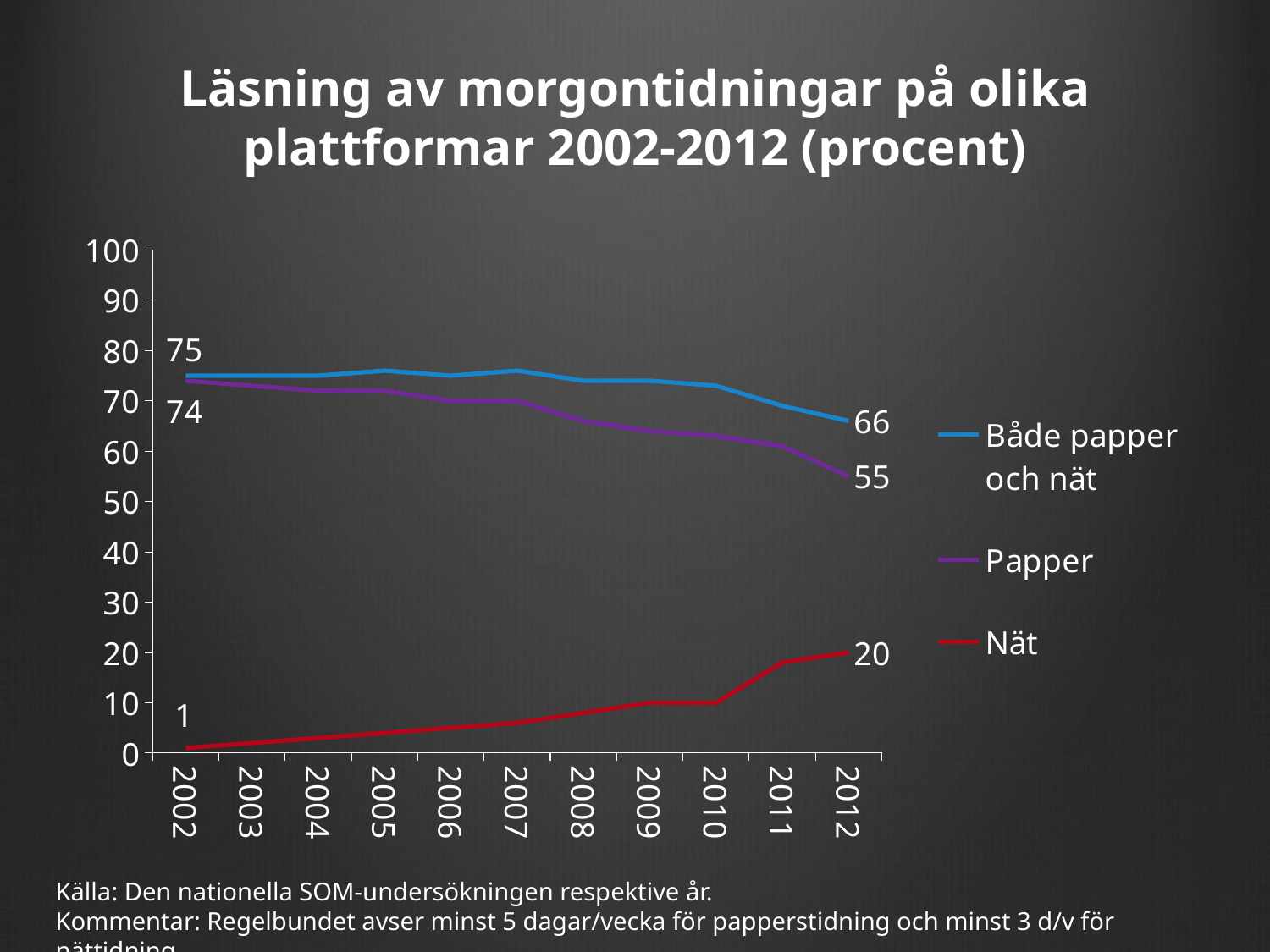
How many years are shown on the x axis? 11 What is the value for 'Nät' in 2012? 20 What is the value for 'Nät' in 2002? 1 By how much did 'Papper' fall from 2002 to 2012? 19 What is the value for 'Både papper och nät' in 2002? 75 How many series does the legend list? 3 Which series has the lowest value in 2012? Nät Does the 'Nät' series rise or fall from 2002 to 2012? rise What is the difference between 'Både papper och nät' and 'Papper' in 2012? 11 Is the value for 'Papper' in 2008 greater or less than 60? greater What kind of chart is shown on the slide? line chart What is the value for 'Papper' in 2012? 55